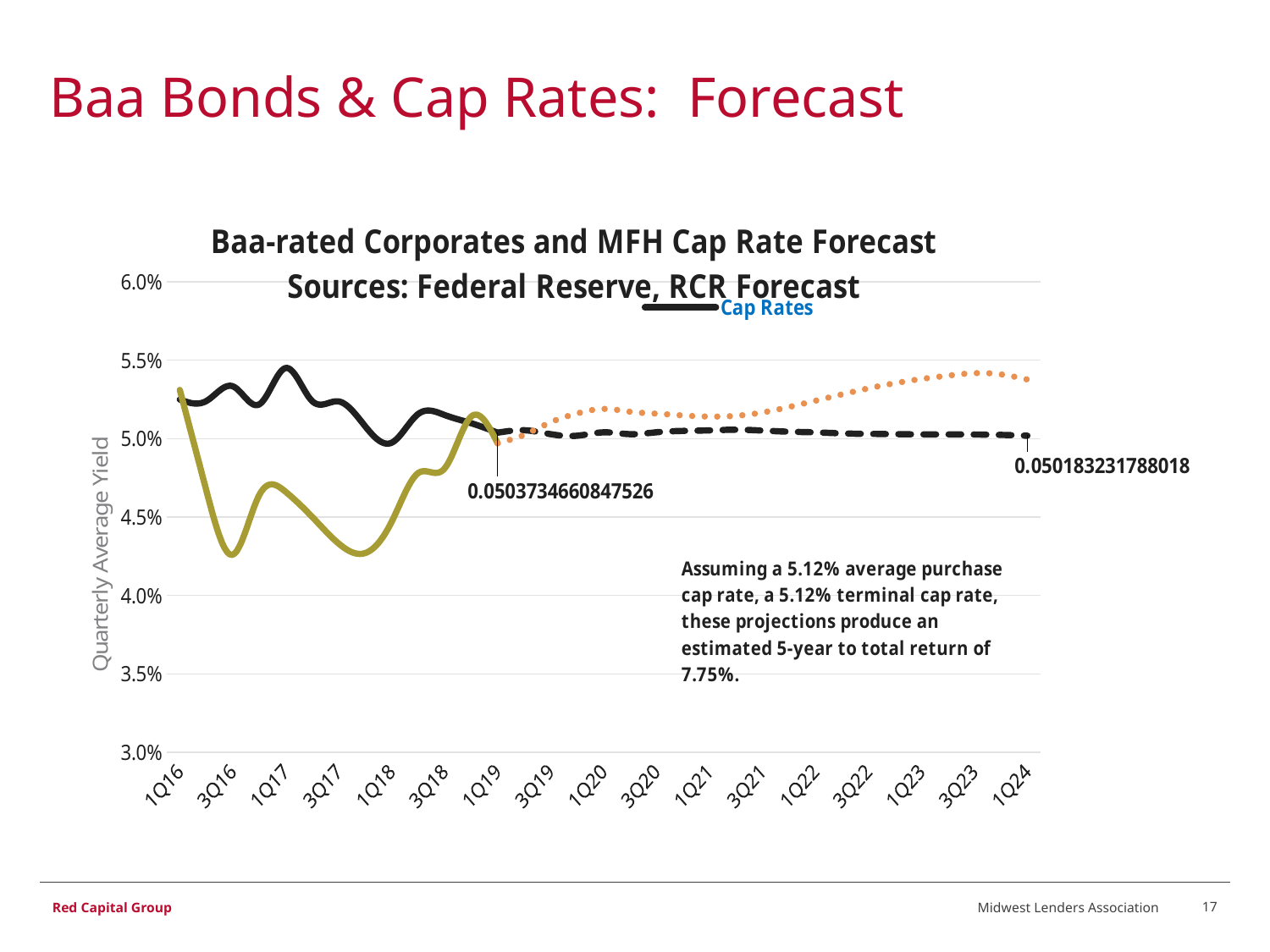
How many series does the legend list? 1 Is the lowest point of the gold solid line greater or less than 4.5%? less What series name appears in the chart legend? Cap Rates Does the labeled cap rate value rise or fall from 1Q19 to 1Q24? fall What data label is printed at 1Q19 on the chart? 0.0503734660847526 What is the title of the vertical axis? Quarterly Average Yield Is the value of the black dashed line at 3Q22 greater or less than 5.5%? less What kind of chart is shown on the slide? line chart Is the peak of the black solid line near 1Q17 greater or less than 5.0%? greater What data label is printed at 1Q24 on the chart? 0.050183231788018 Which of the two printed data labels is larger, the one at 1Q19 or the one at 1Q24? 1Q19